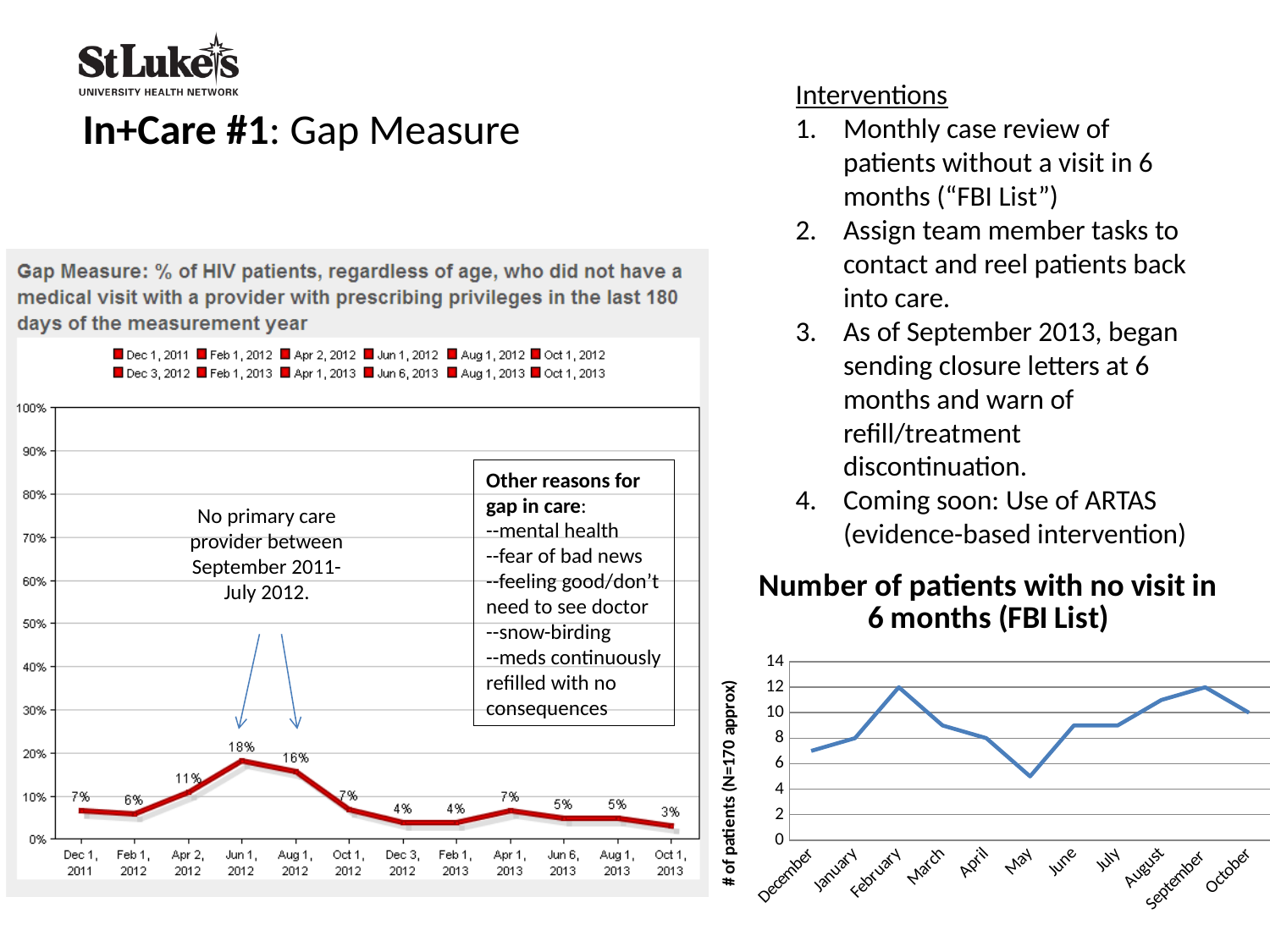
In the Gap Measure chart, what is the value for Jun 1, 2012? 18% In the 'Number of patients with no visit in 6 months (FBI List)' chart, which month has the lowest value? May In the 'Number of patients with no visit in 6 months (FBI List)' chart, what is the value for February? 12 In the Gap Measure chart, what is the difference between the values for Jun 1, 2012 and Aug 1, 2012? 2% In the Gap Measure chart, which date has the highest value? Jun 1, 2012 In the Gap Measure chart, what is the value for Oct 1, 2013? 3% In the 'Number of patients with no visit in 6 months (FBI List)' chart, is the value for August greater or less than 10? greater How many data points are plotted in the Gap Measure chart? 12 In the Gap Measure chart, which date has the lowest value? Oct 1, 2013 What kind of chart is the 'Number of patients with no visit in 6 months (FBI List)' chart? line chart In the 'Number of patients with no visit in 6 months (FBI List)' chart, what is the value for October? 10 In the Gap Measure chart, which is larger, the value for Apr 2, 2012 or the value for Apr 1, 2013? Apr 2, 2012